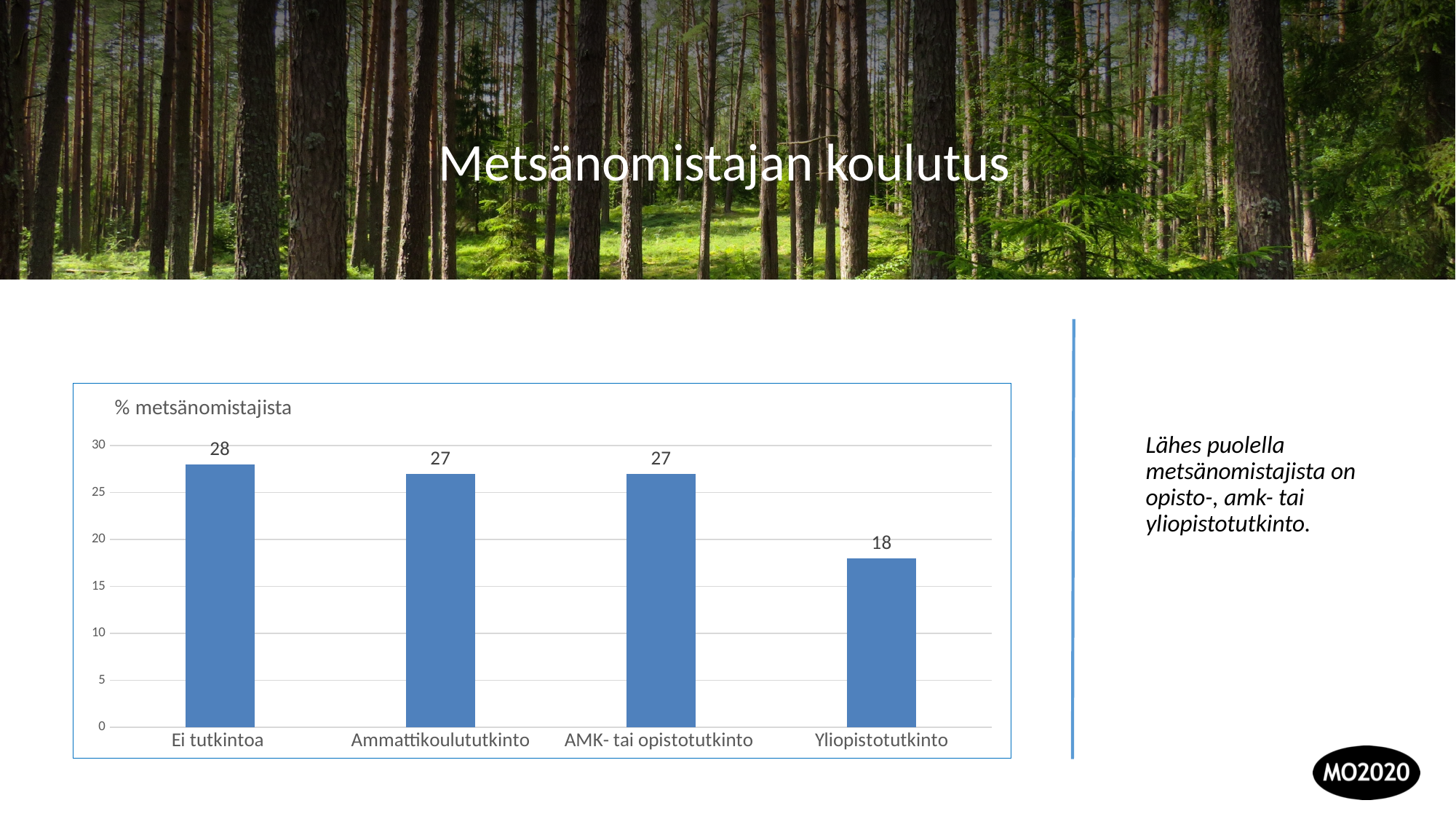
What is the value for Yliopistotutkinto? 18 What is the title of the chart? % metsänomistajista Which category has the lowest value? Yliopistotutkinto Which is larger, the value for Ei tutkintoa or the value for Yliopistotutkinto? Ei tutkintoa What kind of chart is shown on the slide? bar chart Is the value for Yliopistotutkinto greater or less than 20? less How many categories are shown in the chart? 4 What is the difference between the values for AMK- tai opistotutkinto and Yliopistotutkinto? 9 What is the value for Ammattikoulututkinto? 27 What is the value for Ei tutkintoa? 28 Which category has the highest value? Ei tutkintoa What is the difference between the values for Ei tutkintoa and Yliopistotutkinto? 10